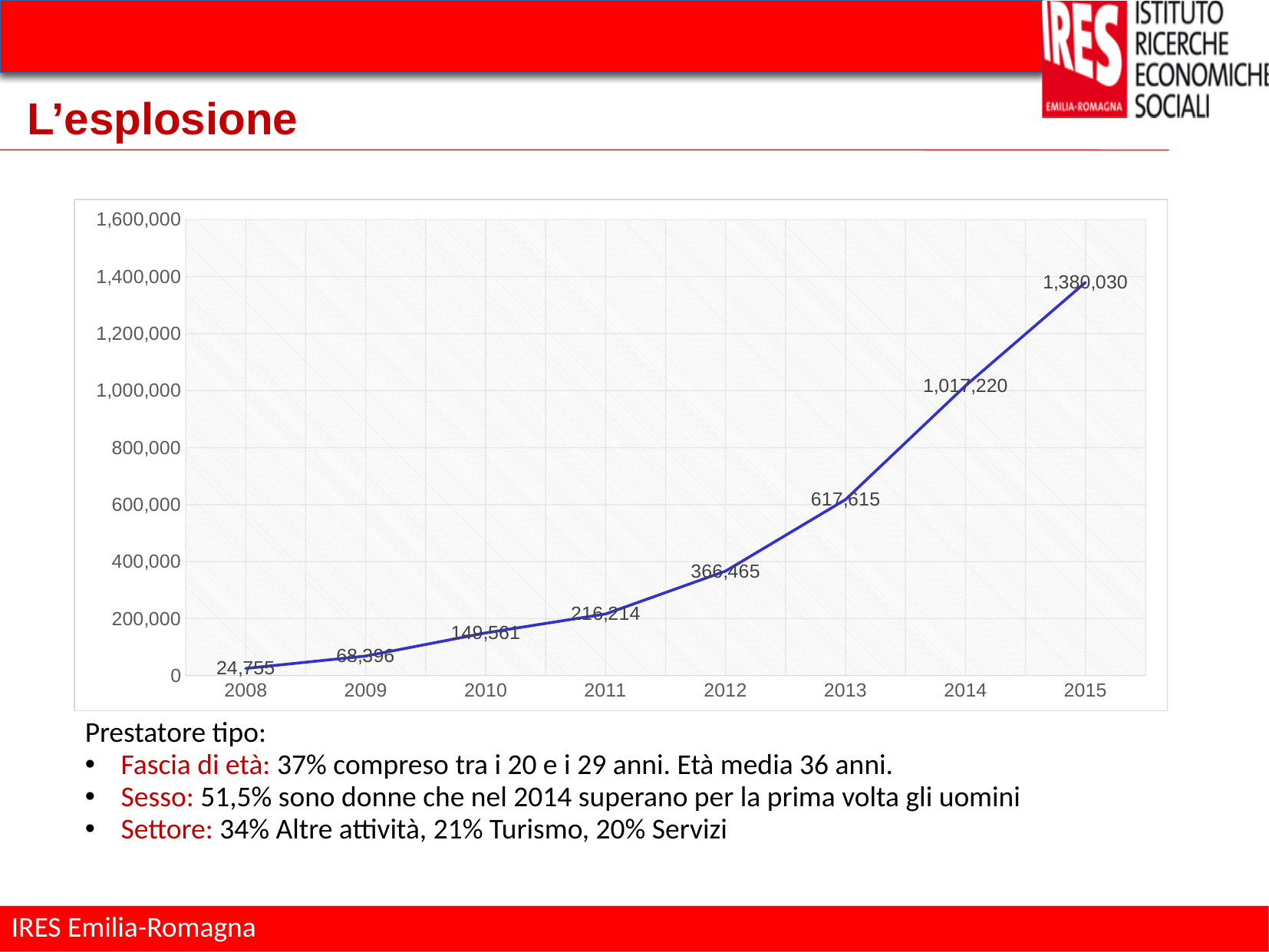
What type of chart is shown on the slide? line chart Which is larger, the value for 2012 or the value for 2013? 2013 Which year has the highest value? 2015 What is the value for 2015? 1,380,030 What is the value for 2013? 617,615 What is the value for 2008? 24,755 How many years are plotted on the x axis? 8 Do the values rise or fall from 2008 to 2015? rise What is the difference between the values for 2015 and 2014? 362,810 Which year has the lowest value? 2008 What is the value for 2011? 216,214 Is the value for 2014 greater or less than 1,000,000? greater